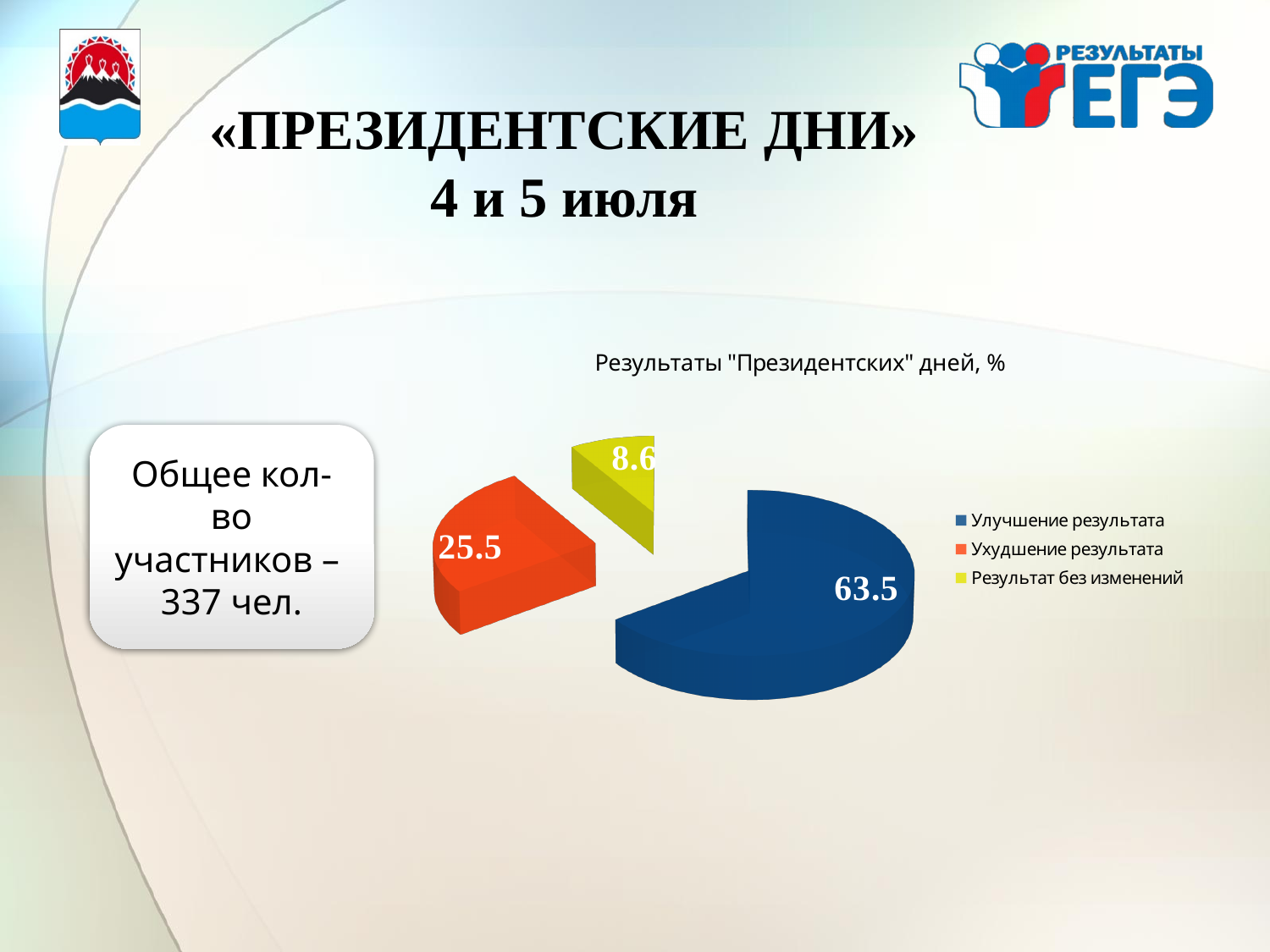
What is the difference between the values for "Ухудшение результата" and "Результат без изменений"? 16.9 What is the value for "Улучшение результата"? 63.5 What is the value for "Ухудшение результата"? 25.5 What type of chart is shown on the slide? pie chart What colour is the slice for "Результат без изменений"? yellow Which category has the largest share of the pie? Улучшение результата Which category has the smallest share of the pie? Результат без изменений Which is larger: "Ухудшение результата" or "Результат без изменений"? Ухудшение результата How many slices does the pie chart have? 3 What is the value for "Результат без изменений"? 8.6 What is the title of the chart? Результаты "Президентских" дней, % What is the difference between the values for "Улучшение результата" and "Ухудшение результата"? 38